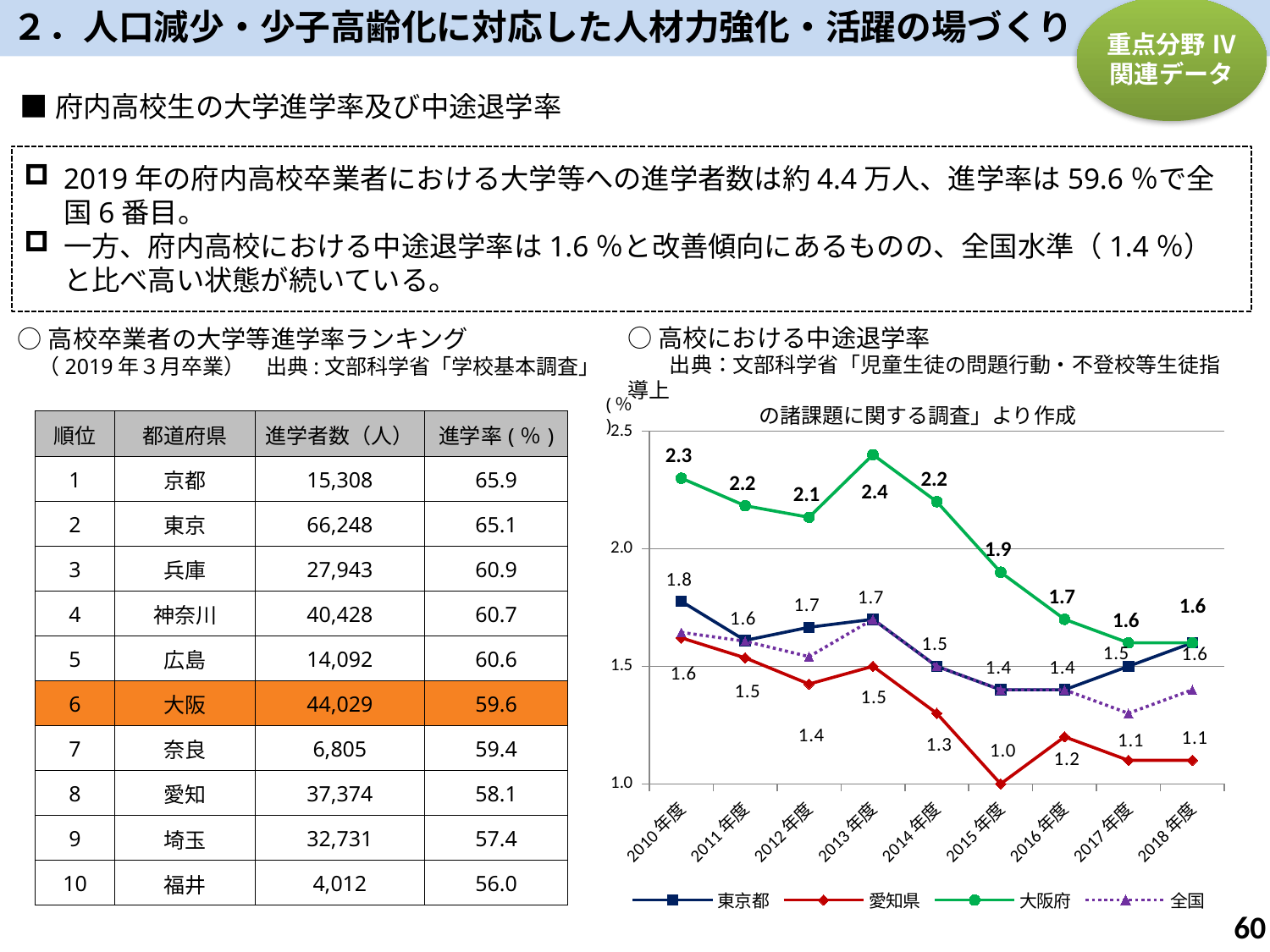
In the 高校における中途退学率 chart, in which year is the 愛知県 value lowest? 2015年度 In the 高校における中途退学率 chart, what is the value for 東京都 in 2010年度? 1.8 In the 高校における中途退学率 chart, what is the difference between the 大阪府 values in 2010年度 and 2018年度? 0.7 In the 高校における中途退学率 chart, in which year is the 大阪府 value highest? 2013年度 How many series does the legend of the 高校における中途退学率 chart list? 4 In the 高校における中途退学率 chart, what is the value for 大阪府 in 2013年度? 2.4 In the 高校における中途退学率 chart, is the value for 全国 in 2017年度 greater or less than 1.5? less In the 高校における中途退学率 chart, does the 大阪府 series rise or fall overall from 2010年度 to 2018年度? fall How many fiscal years are plotted on the x axis of the 高校における中途退学率 chart? 9 In the 高校における中途退学率 chart, what is the value for 愛知県 in 2015年度? 1.0 What kind of chart is the 高校における中途退学率 chart? line chart In the 高校における中途退学率 chart, which is larger in 2015年度: 大阪府 or 愛知県? 大阪府